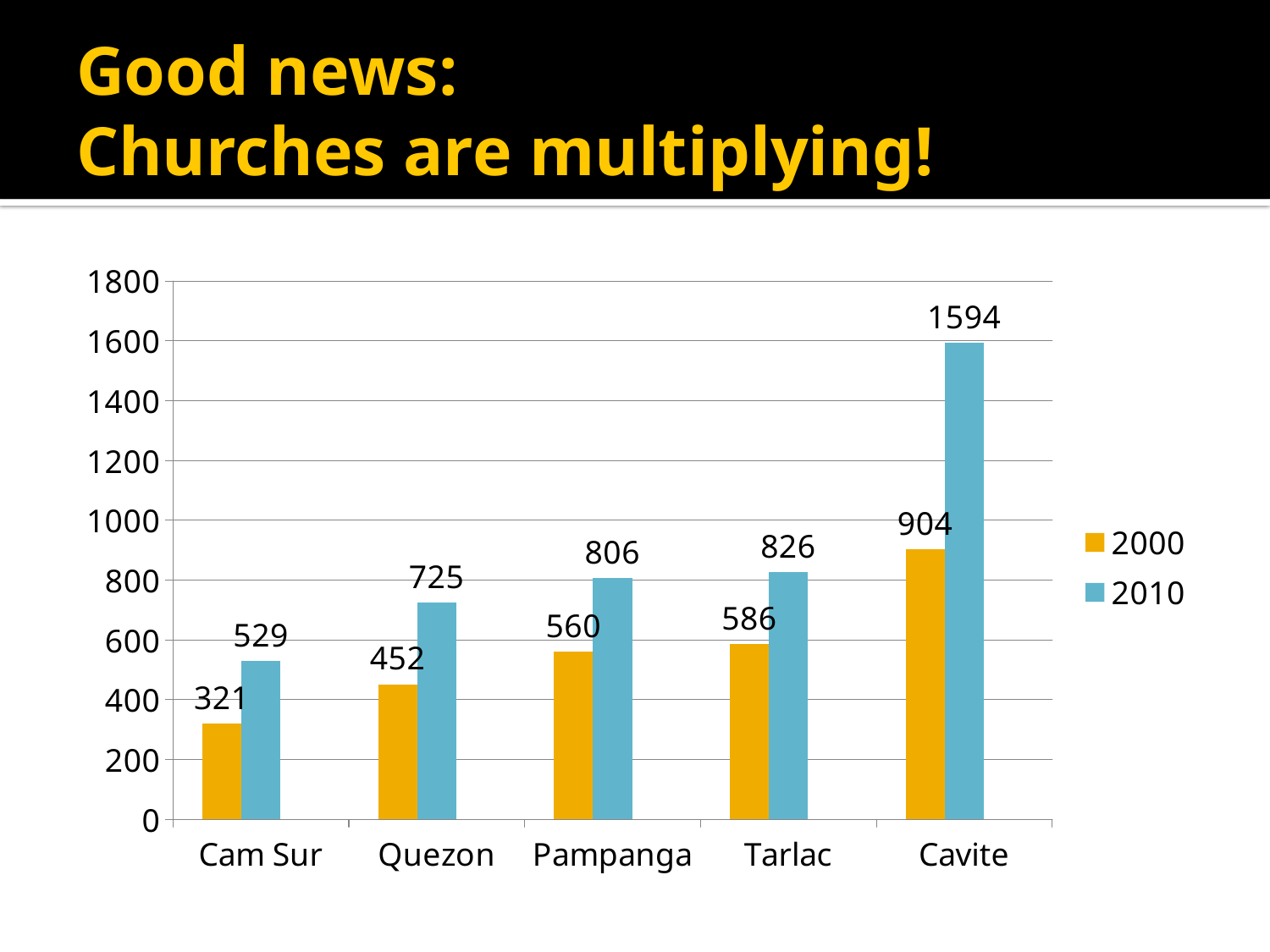
How many series does the legend list? 2 Which is larger: the 2000 value for Tarlac or the 2000 value for Pampanga? Tarlac What is the value for Cam Sur in the 2000 series? 321 What is the difference between the 2010 values for Tarlac and Quezon? 101 What kind of chart is shown on the slide? Bar chart What is the value for Pampanga in the 2010 series? 806 How many categories are shown on the x axis? 5 Which category has the lowest value in the 2000 series? Cam Sur Is the 2010 value for Quezon greater or less than 600? greater What is the difference between the 2010 and 2000 values for Cavite? 690 Which category has the highest value in the 2010 series? Cavite What is the value for Cavite in the 2010 series? 1594